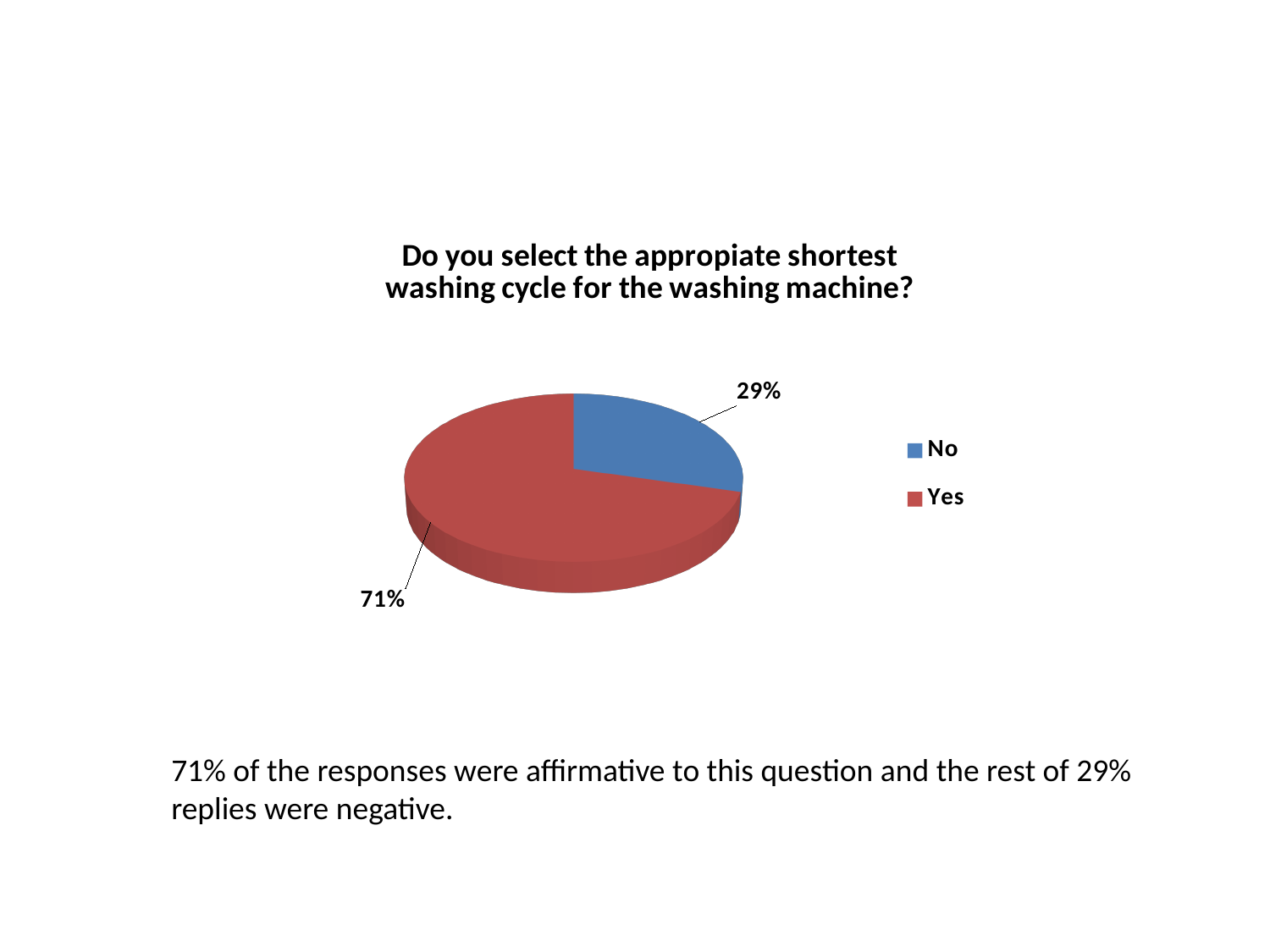
Which is larger, the "Yes" slice or the "No" slice? Yes What is the title of the chart? Do you select the appropiate shortest washing cycle for the washing machine? How many categories are shown in the pie chart? 2 What share of the pie does the "Yes" slice represent? 71% Which category has the smallest slice of the pie? No What type of chart is shown on the slide? pie chart Which category has the largest slice of the pie? Yes How many entries does the legend list? 2 What colour is the "No" slice in the pie chart? blue What is the difference in percentage points between the "Yes" and "No" slices? 42 What share of the pie does the "No" slice represent? 29%